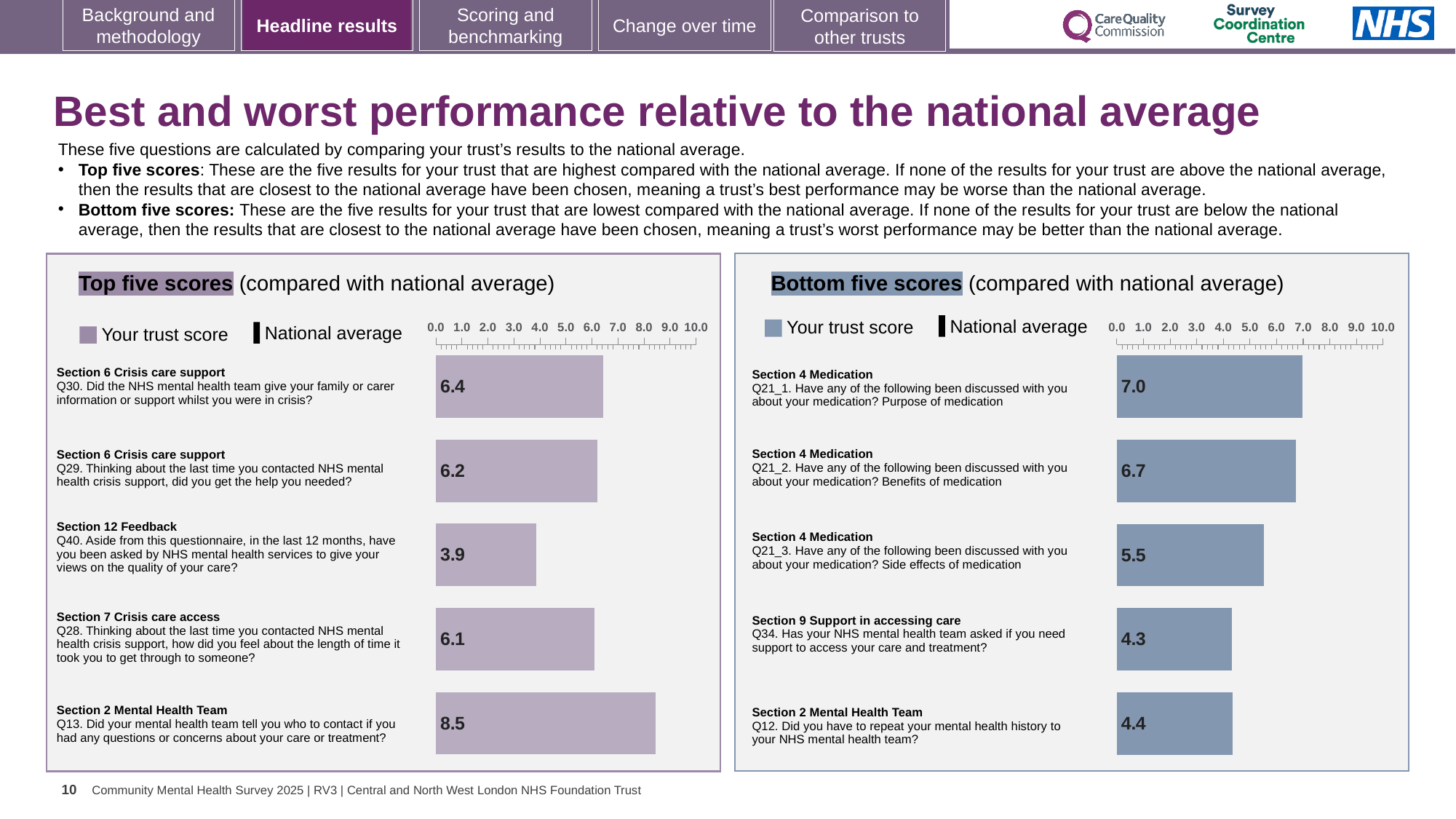
What kind of chart is used in the 'Bottom five scores' panel? Bar chart In the 'Top five scores' chart, what is the trust score for Q40 (have you been asked by NHS mental health services to give your views on the quality of your care?)? 3.9 In the 'Bottom five scores' chart, what is the difference between the trust scores for Q21_2 and Q21_3? 1.2 In the 'Top five scores' chart, which question has the highest trust score? Q13 In the 'Top five scores' chart, is the trust score for Q28 greater or less than 5.0? greater In the 'Bottom five scores' chart, what is the trust score for Q21_1 (Purpose of medication)? 7.0 In the 'Top five scores' chart, what is the trust score for Q13 (Did your mental health team tell you who to contact if you had any questions or concerns about your care or treatment?)? 8.5 In the 'Bottom five scores' chart, which question has the lowest trust score? Q34 In the 'Top five scores' chart, what is the difference between the trust scores for Q30 and Q29? 0.2 In the 'Bottom five scores' chart, what is the trust score for Q34 (Has your NHS mental health team asked if you need support to access your care and treatment?)? 4.3 In the 'Top five scores' chart, which question has the lowest trust score? Q40 In the 'Bottom five scores' chart, which question has the highest trust score? Q21_1